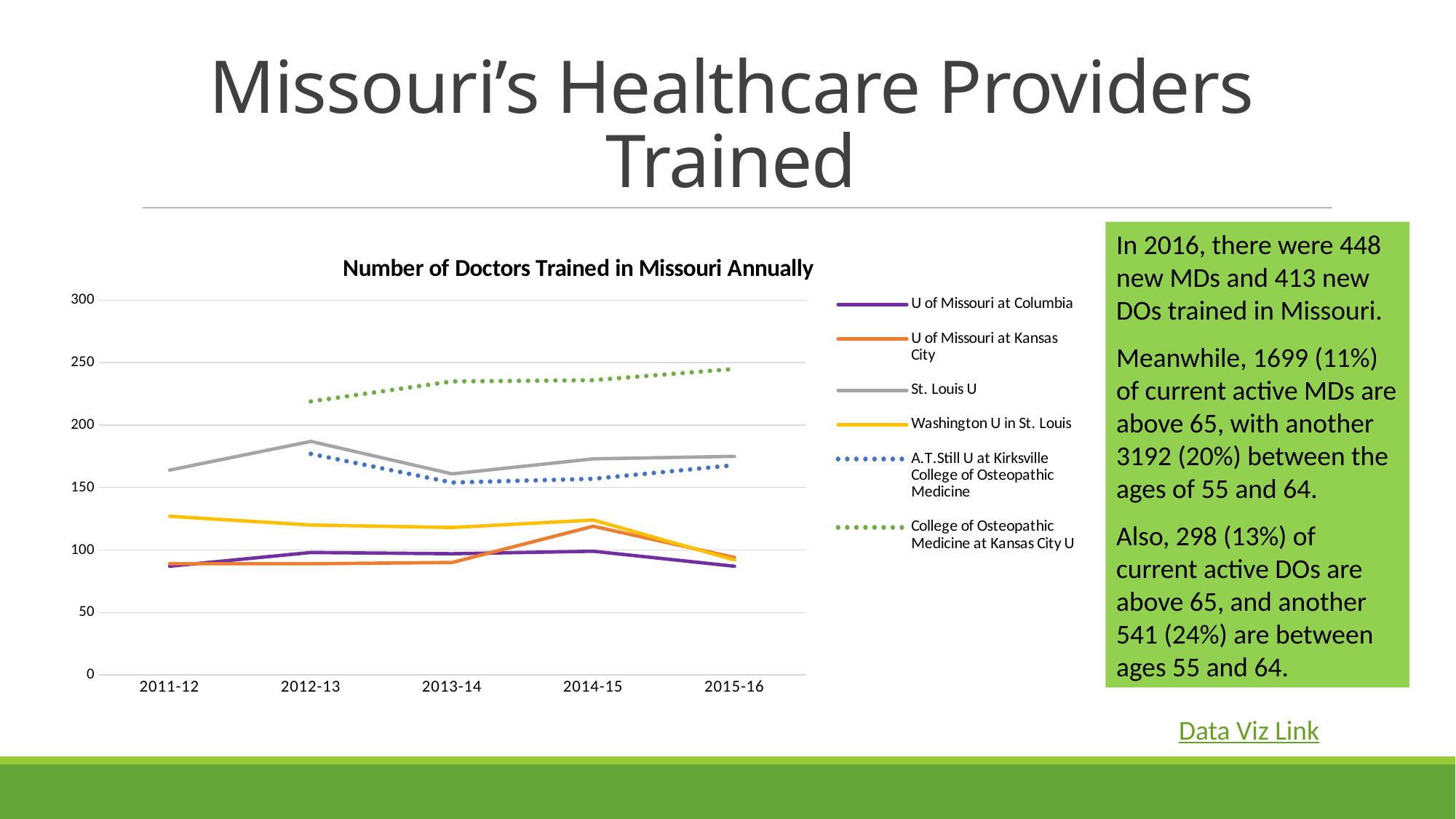
Which series is drawn in gray in the chart? St. Louis U Is the value for College of Osteopathic Medicine at Kansas City U in 2015-16 greater or less than 200? greater In 2013-14, which is larger: Washington U in St. Louis or U of Missouri at Kansas City? Washington U in St. Louis What kind of chart is shown on the slide? line chart Is the value for St. Louis U in 2012-13 greater or less than 200? less Does the College of Osteopathic Medicine at Kansas City U series rise or fall from 2012-13 to 2015-16? rise How many academic years are shown on the x axis of the chart? 5 How many series does the legend of the chart list? 6 What is the title of the chart? Number of Doctors Trained in Missouri Annually Is the value for Washington U in St. Louis in 2011-12 greater or less than 100? greater Which series has the highest value in 2015-16? College of Osteopathic Medicine at Kansas City U Which series has the lowest value in 2014-15? U of Missouri at Columbia